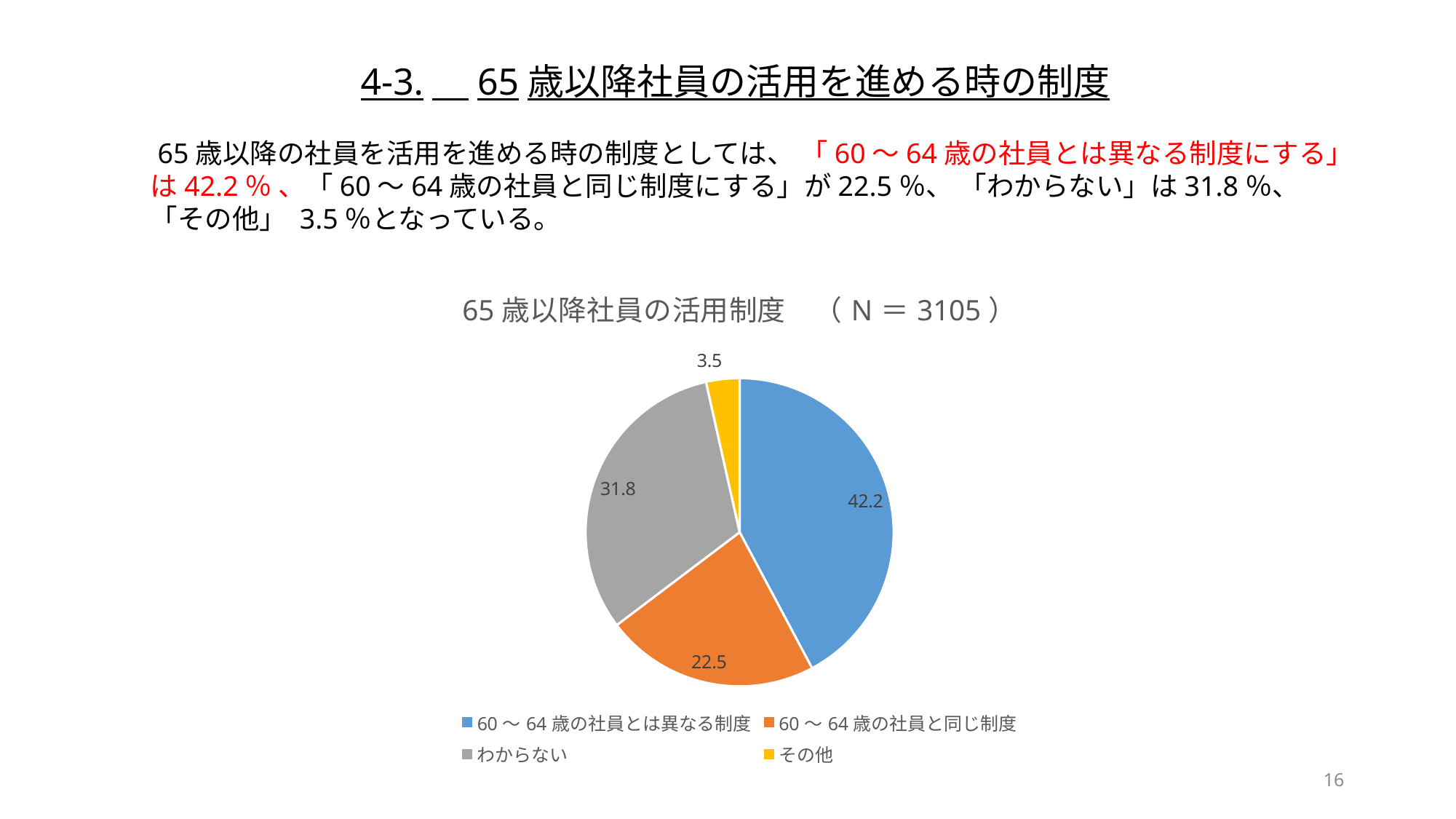
What is the difference between the values for 「60～64歳の社員とは異なる制度」 and 「60～64歳の社員と同じ制度」? 19.7 What colour is the slice for 「わからない」? gray Which category has the largest slice in the pie chart? 60～64歳の社員とは異なる制度 What is the title of the pie chart? 65歳以降社員の活用制度 （N＝3105） What is the value for 「わからない」 in the pie chart? 31.8 What is the value for 「その他」 in the pie chart? 3.5 What kind of chart is shown on the slide? pie chart Which is larger, the value for 「わからない」 or the value for 「60～64歳の社員と同じ制度」? わからない Which category has the smallest slice in the pie chart? その他 How many slices does the pie chart have? 4 What is the value for 「60～64歳の社員とは異なる制度」 in the pie chart? 42.2 What is the value for 「60～64歳の社員と同じ制度」 in the pie chart? 22.5